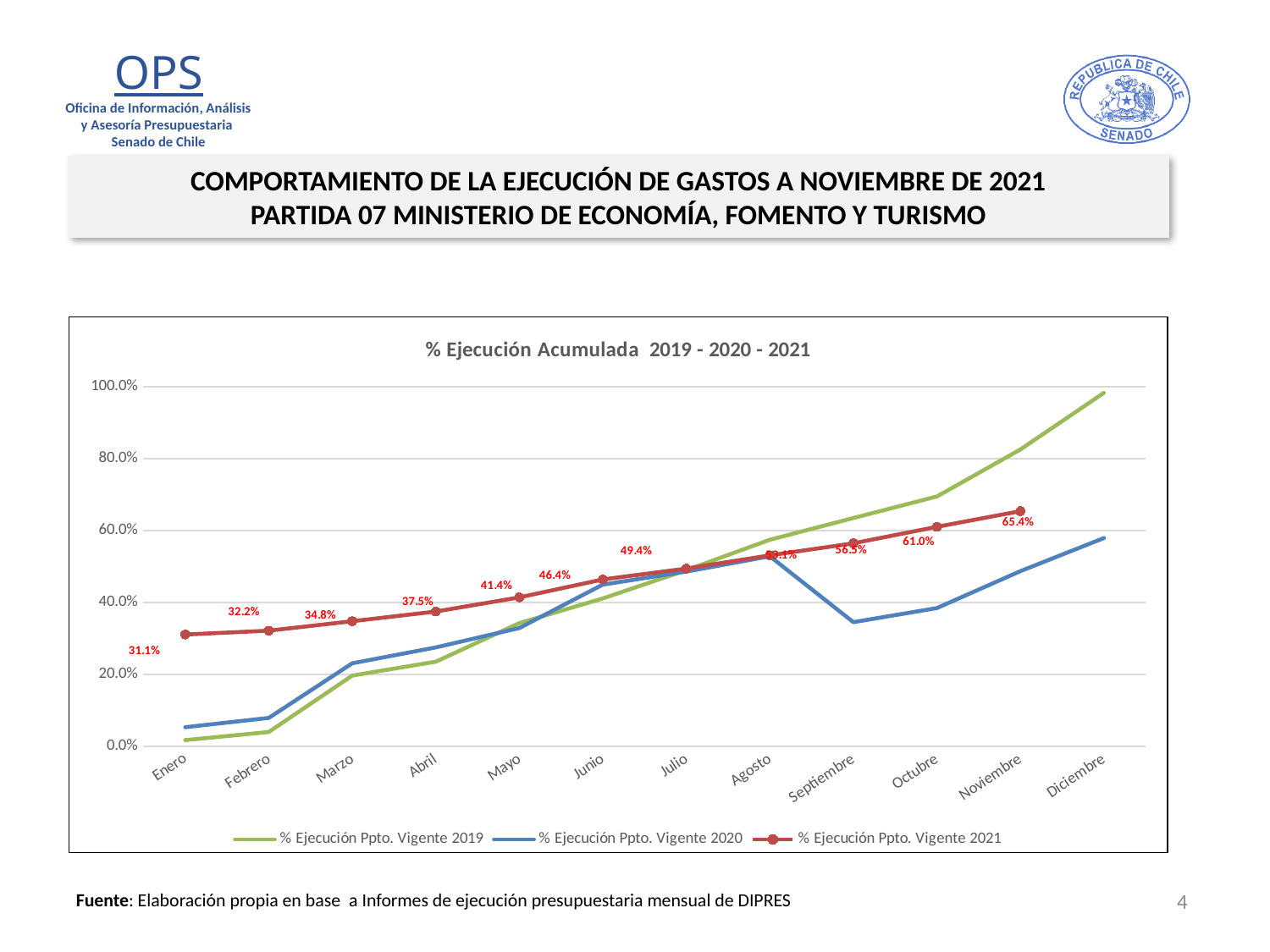
What is the title of the chart? % Ejecución Acumulada 2019 - 2020 - 2021 What type of chart is shown on the slide? Line chart What is the difference between the 2021 values for Octubre and Julio? 11.6 percentage points Does the % Ejecución Ppto. Vigente 2021 line rise or fall from Enero to Noviembre? Rises How many months are shown on the x axis? 12 What is the difference between the 2021 values for Noviembre and Enero? 34.3 percentage points What is the value of % Ejecución Ppto. Vigente 2021 for Enero? 31.1% Is the value for % Ejecución Ppto. Vigente 2019 in Diciembre greater or less than 80.0%? greater How many series does the legend list? 3 What is the value of % Ejecución Ppto. Vigente 2021 for Noviembre? 65.4% What is the value of % Ejecución Ppto. Vigente 2021 for Octubre? 61.0% What is the value of % Ejecución Ppto. Vigente 2021 for Mayo? 41.4%